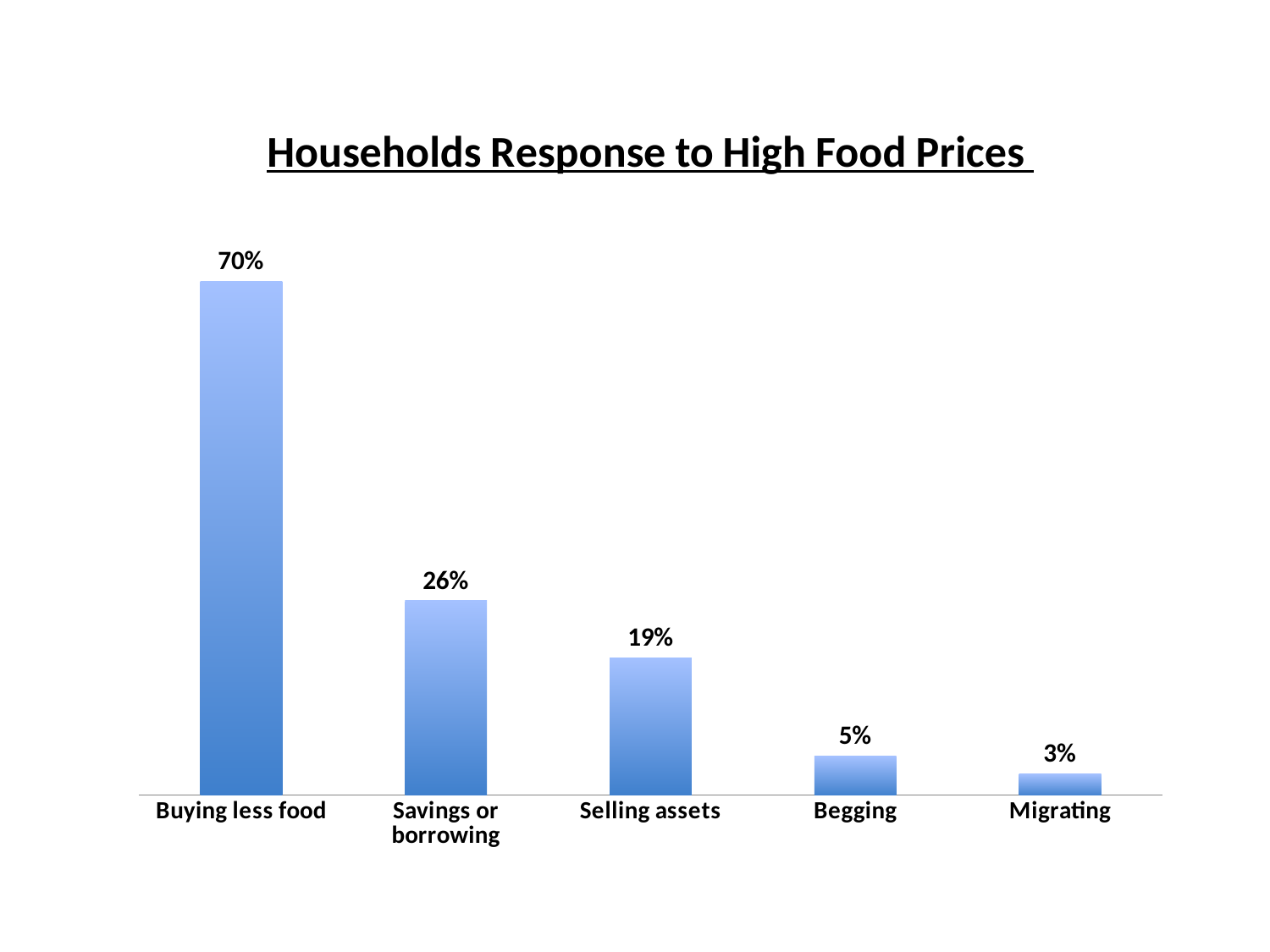
What is the value for Migrating? 3% Which is larger, the value for Selling assets or the value for Begging? Selling assets What is the value for Selling assets? 19% What is the value for Savings or borrowing? 26% What is the difference between the values for Begging and Migrating? 2% Which household response has the lowest percentage? Migrating Which household response has the highest percentage? Buying less food What percentage of households responded by buying less food? 70% What is the difference between the values for Buying less food and Savings or borrowing? 44% What is the title of the chart? Households Response to High Food Prices What kind of chart is shown on the slide? Bar chart How many household response categories are shown in the chart? 5